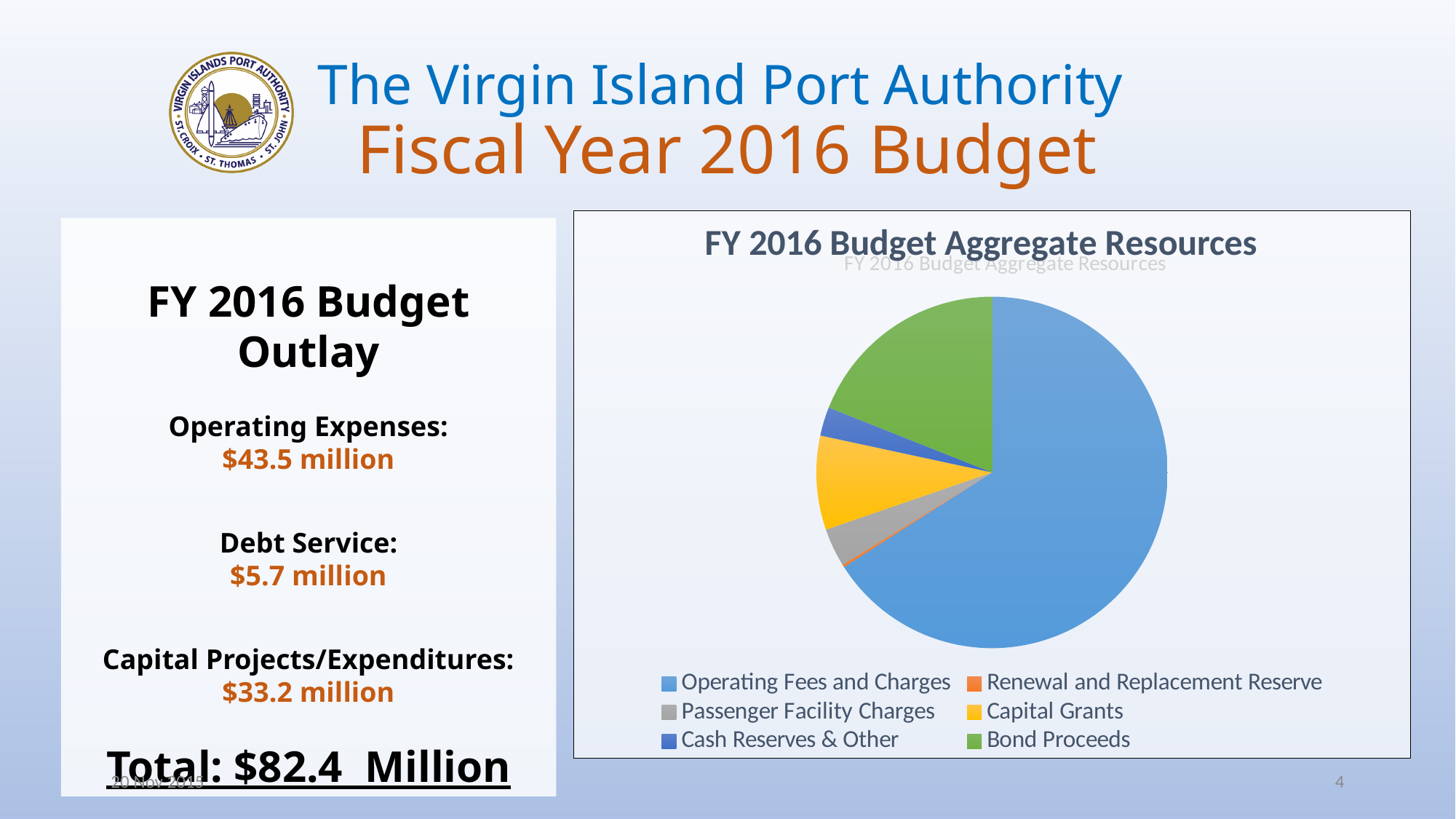
Which category has the largest slice of the pie? Operating Fees and Charges Which slice is larger, Operating Fees and Charges or Bond Proceeds? Operating Fees and Charges Which slice is larger, Capital Grants or Cash Reserves & Other? Capital Grants Which slice is larger, Bond Proceeds or Cash Reserves & Other? Bond Proceeds Which category has the smallest slice of the pie? Renewal and Replacement Reserve What is the title of the chart? FY 2016 Budget Aggregate Resources Does the Operating Fees and Charges slice make up more or less than half of the pie? more How many categories does the pie chart's legend list? 6 What kind of chart is shown on the slide? pie chart What colour is the Capital Grants slice in the pie chart? yellow